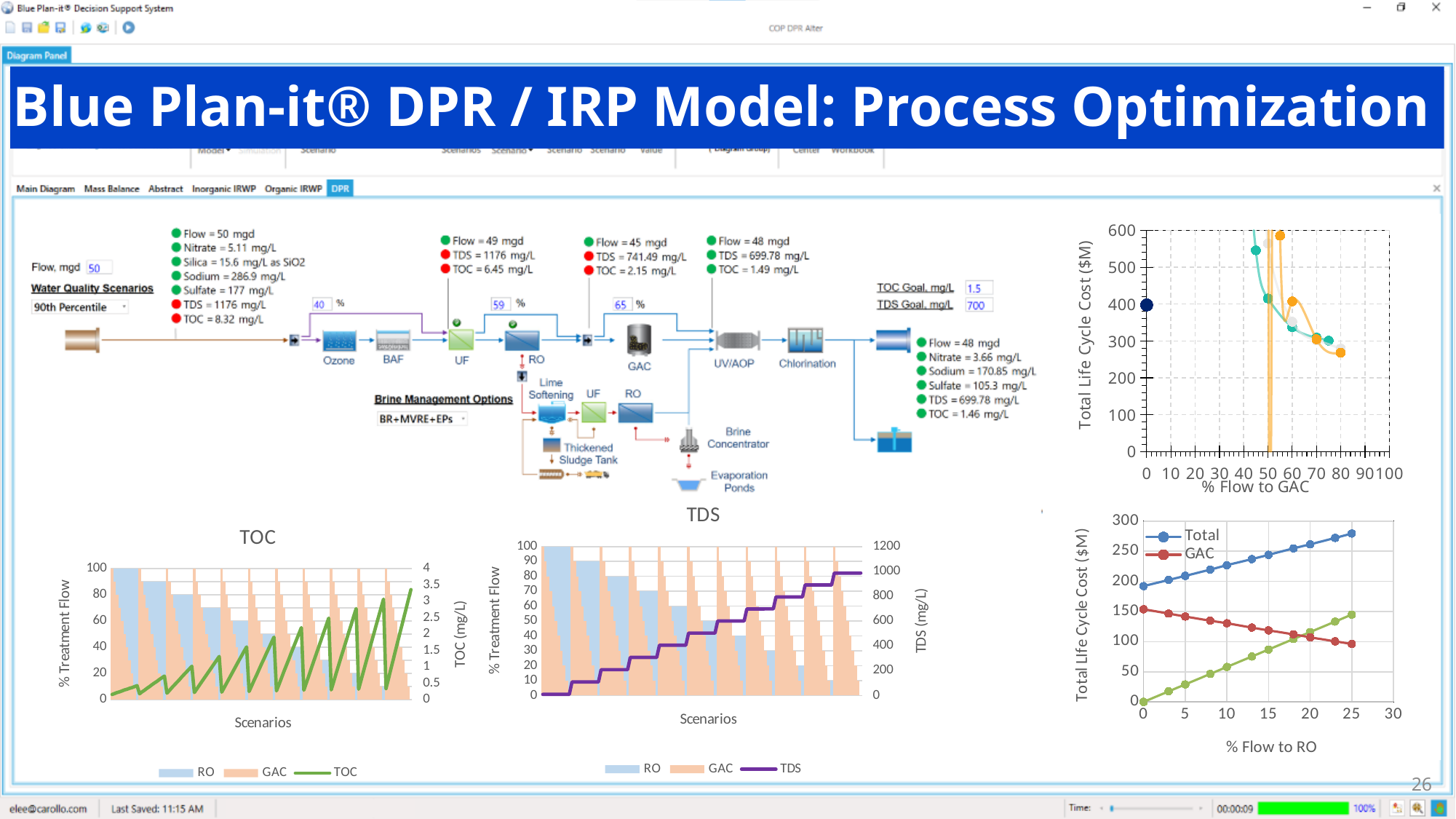
On the TOC chart, how many series does the legend list? 3 On the chart with x axis '% Flow to GAC', what is the label of the vertical axis? Total Life Cycle Cost ($M) On the TOC chart, what are the legend entries? RO, GAC, TOC On the TDS chart, what is the label of the right-hand vertical axis? TDS (mg/L) On the chart with x axis '% Flow to RO', is the Total value at 25% flow to RO greater or less than 250? greater On the chart with x axis '% Flow to RO', does the GAC series rise or fall as % Flow to RO increases? fall On the TDS chart, how many series does the legend list? 3 On the chart with x axis '% Flow to RO', does the Total series rise or fall as % Flow to RO increases? rise On the TDS chart, does the TDS line rise or fall along the x axis? rise On the chart with x axis '% Flow to RO', how many series does the legend list? 2 On the chart with x axis '% Flow to RO', is the GAC value at 0% flow to RO greater or less than 100? greater On the chart with x axis '% Flow to GAC', is the value at 0% flow to GAC greater or less than 300? greater